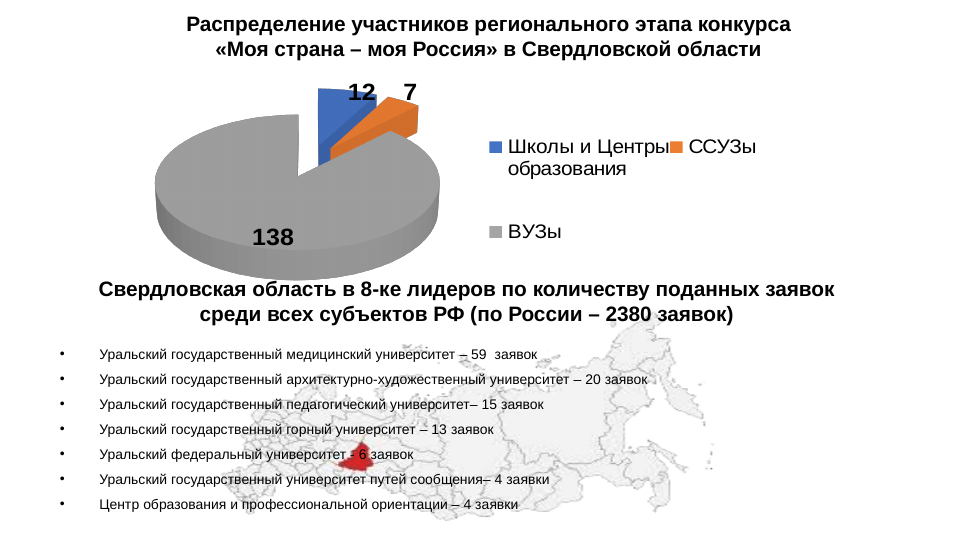
What kind of chart is shown on the slide? Pie chart What is the value for ВУЗы in the pie chart? 138 What is the difference between the values for Школы и Центры образования and ССУЗы? 5 What is the total of all three slices in the pie chart? 157 What colour is the ВУЗы slice in the pie chart? Gray Which category has the largest slice in the pie chart? ВУЗы What is the value for ССУЗы in the pie chart? 7 Which is larger: the value for Школы и Центры образования or the value for ССУЗы? Школы и Центры образования How many categories does the pie chart show? 3 What is the difference between the values for ВУЗы and Школы и Центры образования? 126 What is the value for Школы и Центры образования in the pie chart? 12 Which category has the smallest slice in the pie chart? ССУЗы